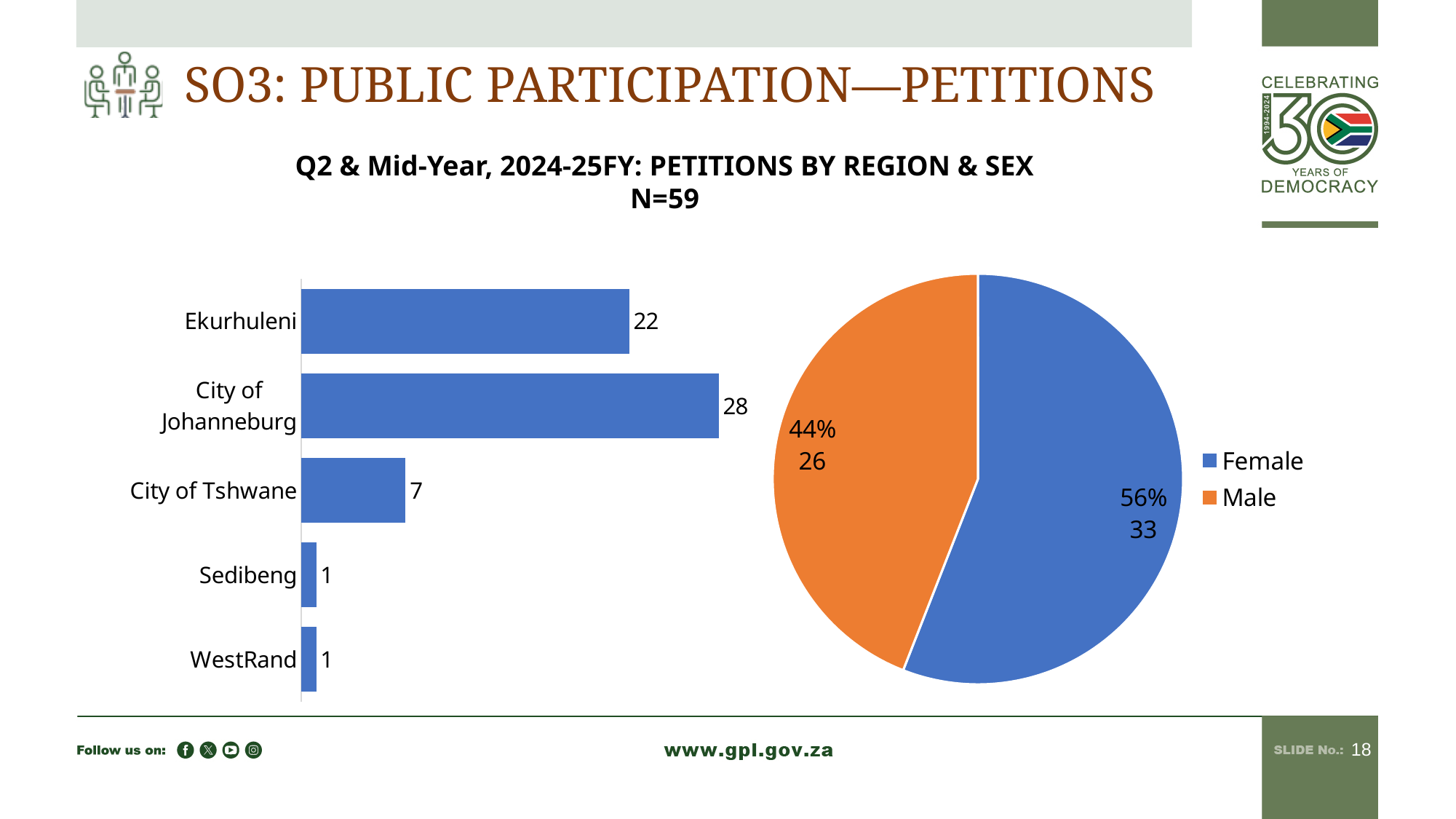
How many regions are shown in the bar chart on the left? 5 In the pie chart on the right, which slice is larger, Female or Male? Female How many entries does the legend of the pie chart on the right list? 2 In the bar chart on the left, which is larger, the value for Ekurhuleni or the value for City of Tshwane? Ekurhuleni In the bar chart on the left, what is the difference between the values for City of Johanneburg and Ekurhuleni? 6 In the pie chart on the right, what percentage of petitions is Female? 56% In the bar chart on the left, how many petitions are shown for Ekurhuleni? 22 In the bar chart on the left, what is the value for City of Tshwane? 7 In the pie chart on the right, what colour is the Male slice? Orange In the pie chart on the right, what is the number of petitions for Male? 26 In the bar chart on the left, which region has the highest value? City of Johanneburg What kind of chart is the chart on the left? Bar chart